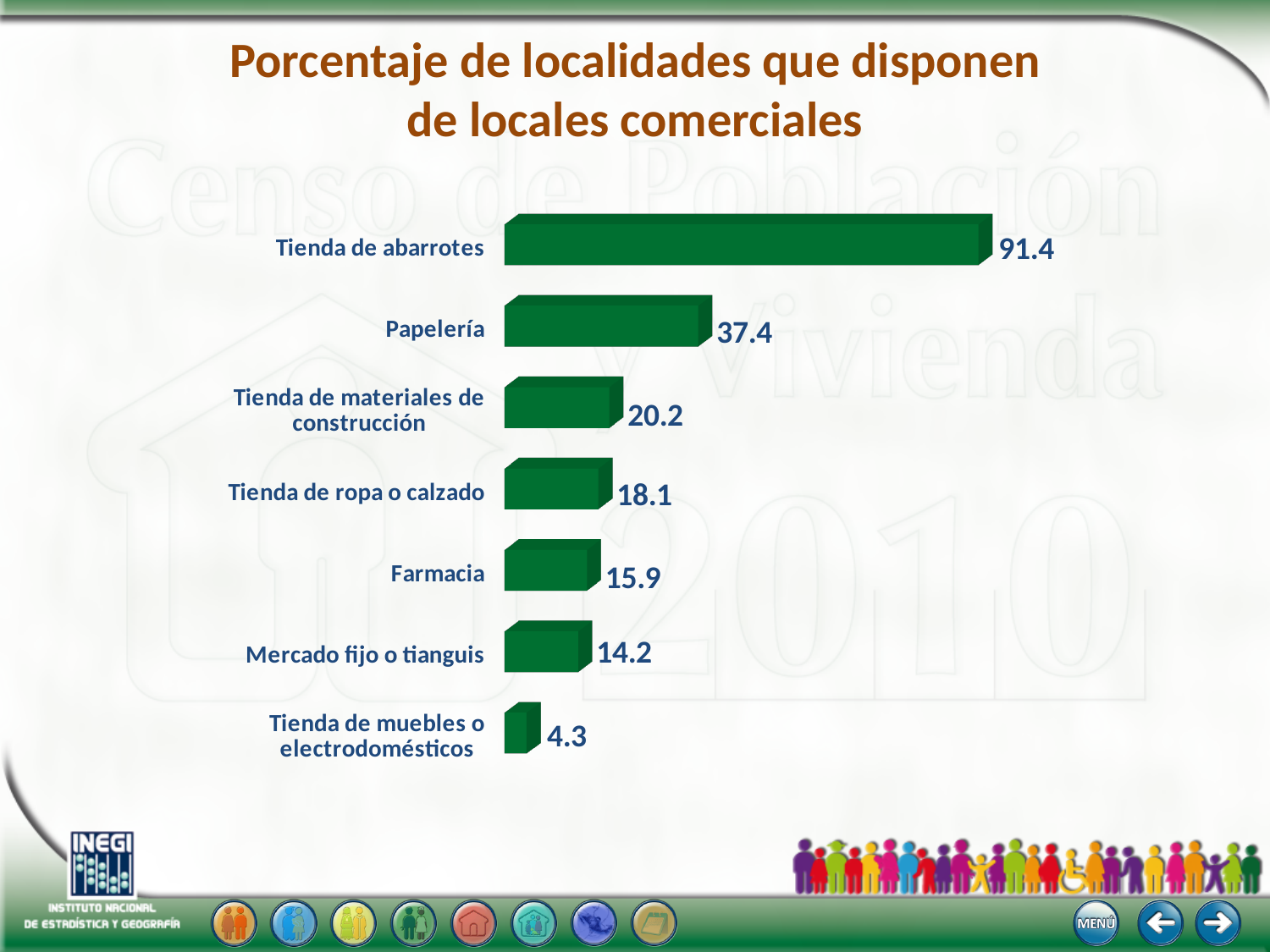
What is the value shown for Farmacia? 15.9 What is the value shown for Mercado fijo o tianguis? 14.2 What kind of chart is shown on the slide? Bar chart What is the difference between the values for Tienda de materiales de construcción and Tienda de ropa o calzado? 2.1 Which category has the lowest value? Tienda de muebles o electrodomésticos What is the value shown for Papelería? 37.4 What is the title of the chart? Porcentaje de localidades que disponen de locales comerciales What percentage of localities have a Tienda de abarrotes? 91.4 Which category has the highest value? Tienda de abarrotes What is the difference between the values for Tienda de abarrotes and Papelería? 54.0 How many categories are shown in the chart? 7 Which is larger, the value for Farmacia or the value for Mercado fijo o tianguis? Farmacia